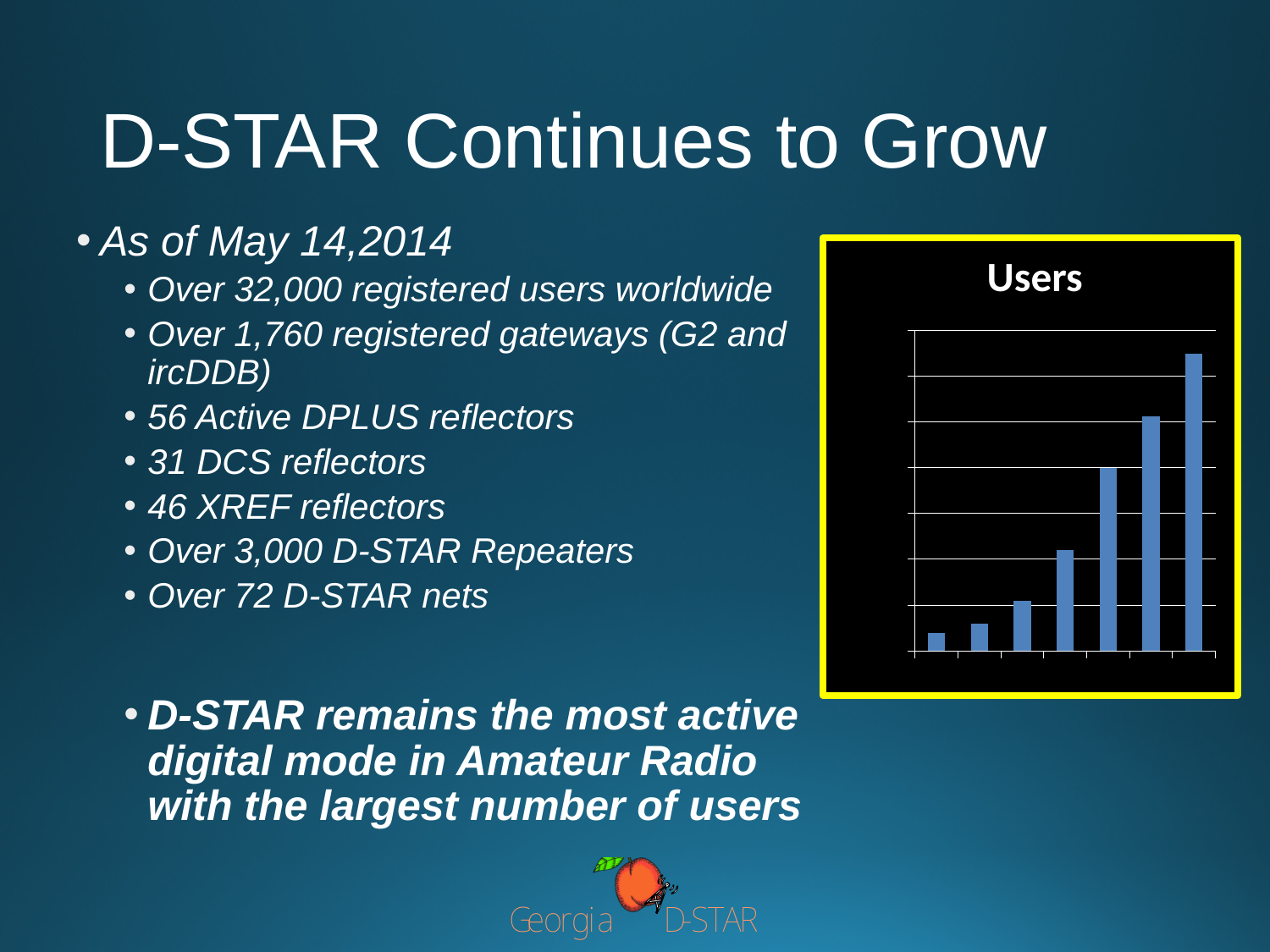
Which bar in the Users chart is the shortest? the leftmost bar Which bar in the Users chart is the tallest? the rightmost bar What colour are the bars in the Users chart? blue Do the values in the Users chart rise or fall from left to right? rise In the Users chart, is the rightmost bar taller or shorter than the leftmost bar? taller How many bars does the Users chart contain? 7 In the Users chart, is the fourth bar from the left taller or shorter than the fifth bar from the left? shorter What kind of chart is shown on the slide? bar chart Are the bars in the Users chart vertical or horizontal? vertical What is the title of the chart on the slide? Users